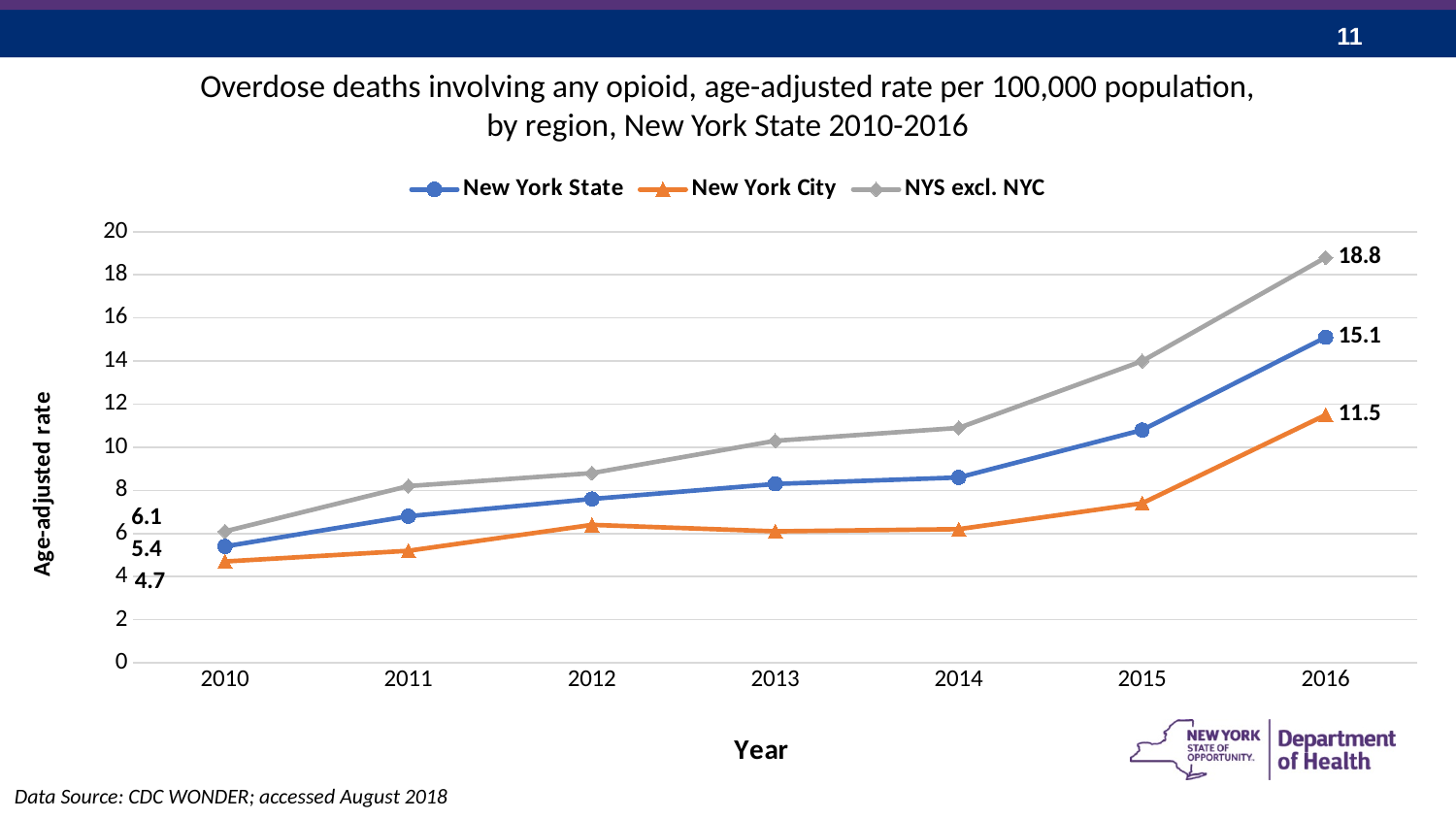
Which region has the lowest age-adjusted rate in 2010? New York City How many series does the legend list? 3 What is the difference between the New York State rate in 2016 and in 2010? 9.7 What is the age-adjusted rate for New York City in 2010? 4.7 What type of chart is shown on the slide? Line chart Is the New York City rate in 2016 larger or smaller than the New York State rate in 2016? Smaller Which region has the highest age-adjusted rate in 2016? NYS excl. NYC Is the value for NYS excl. NYC in 2015 greater or less than 12? greater What is the age-adjusted rate for NYS excl. NYC in 2016? 18.8 What is the age-adjusted rate for New York State in 2016? 15.1 Do the values for NYS excl. NYC rise or fall from 2010 to 2016? Rise How many years are plotted along the x axis? 7